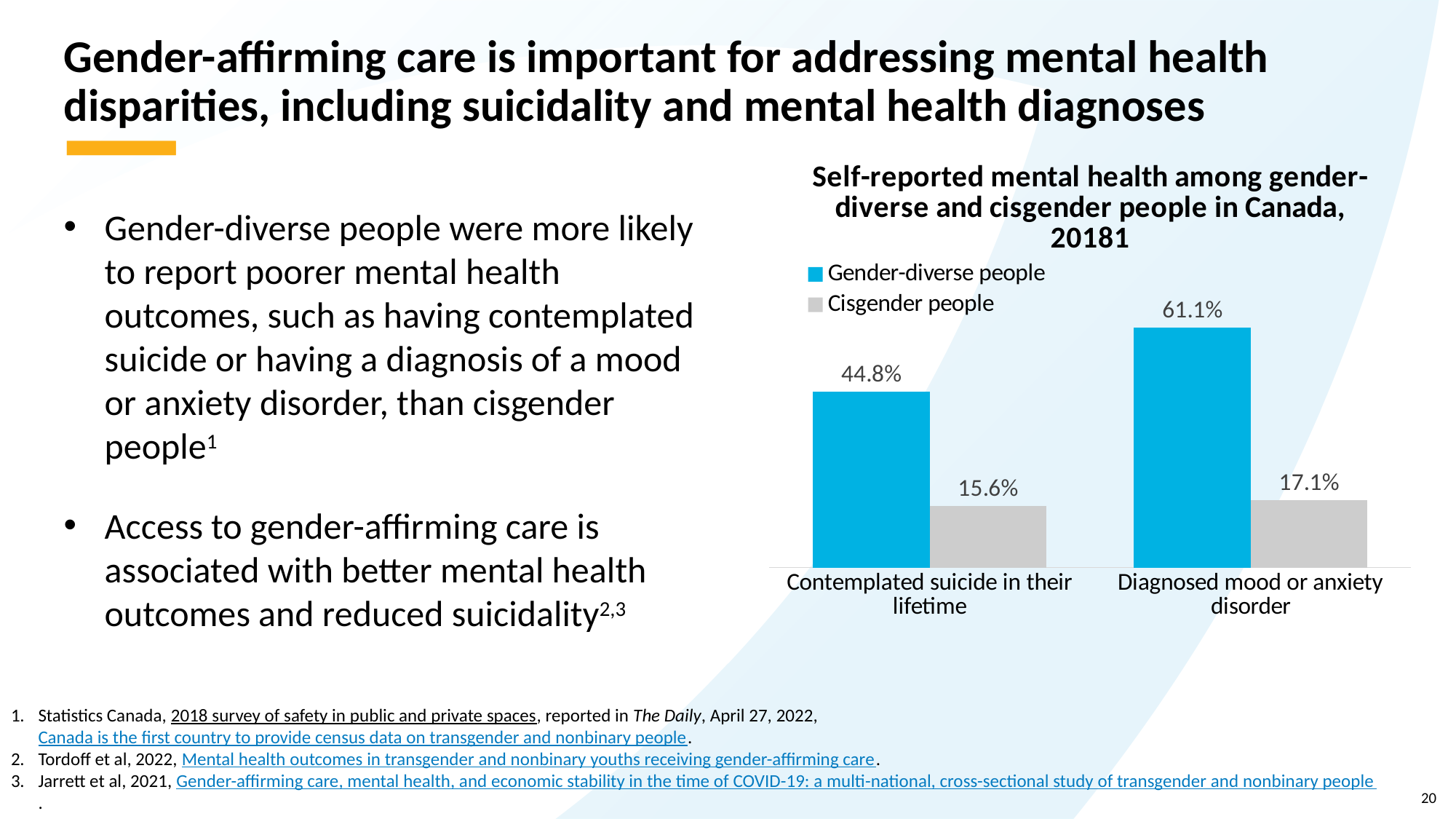
Which bar in the chart has the lowest value? Cisgender people, Contemplated suicide in their lifetime What percentage of gender-diverse people reported a diagnosed mood or anxiety disorder? 61.1% What percentage of cisgender people reported a diagnosed mood or anxiety disorder? 17.1% What percentage of cisgender people reported having contemplated suicide in their lifetime? 15.6% For diagnosed mood or anxiety disorder, which group has the larger value: gender-diverse people or cisgender people? Gender-diverse people What is the difference between gender-diverse and cisgender people for diagnosed mood or anxiety disorder? 44.0% What type of chart is shown on the slide? Bar chart What percentage of gender-diverse people reported having contemplated suicide in their lifetime? 44.8% What is the difference between gender-diverse and cisgender people for contemplated suicide in their lifetime? 29.2% How many categories are shown on the x axis of the chart? 2 Which bar in the chart has the highest value? Gender-diverse people, Diagnosed mood or anxiety disorder How many series does the chart legend list? 2